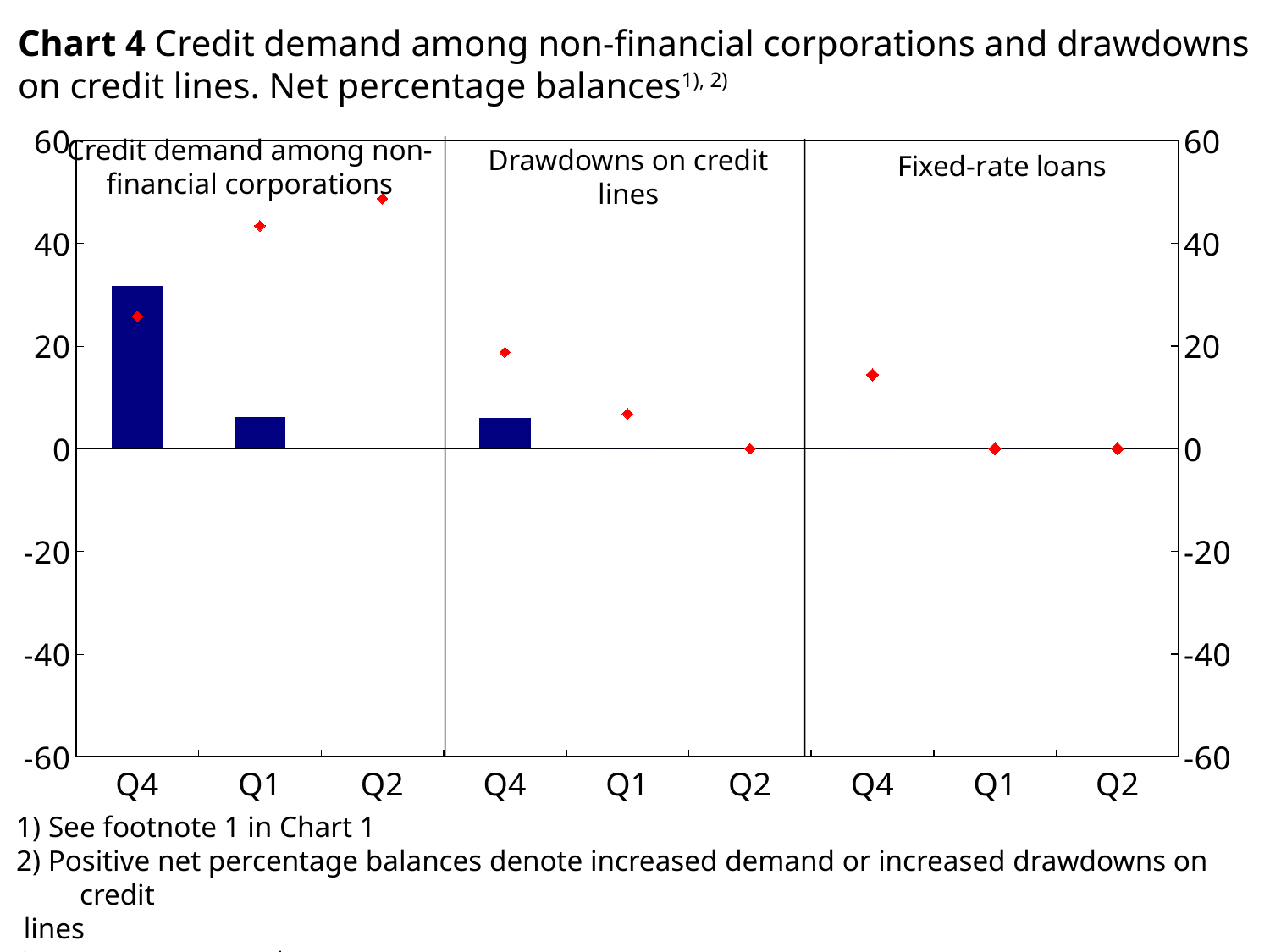
What kind of chart is shown on the slide? combination chart with bars and diamond markers What is the title of the right-hand panel of the chart? Fixed-rate loans In the 'Credit demand among non-financial corporations' panel, which quarter has the taller bar, Q4 or Q1? Q4 In the 'Credit demand among non-financial corporations' panel, is the bar for Q1 greater or less than 20? less In the 'Credit demand among non-financial corporations' panel, is the bar for Q4 greater or less than 20? greater In the 'Credit demand among non-financial corporations' panel, is the red diamond for Q2 greater or less than 40? greater What is the title of the middle panel of the chart? Drawdowns on credit lines In the 'Fixed-rate loans' panel, which quarter has the highest red diamond? Q4 How many panels does the chart have? 3 In the 'Credit demand among non-financial corporations' panel, do the red diamonds rise or fall from Q4 to Q2? rise In the 'Drawdowns on credit lines' panel, do the red diamonds rise or fall from Q4 to Q2? fall